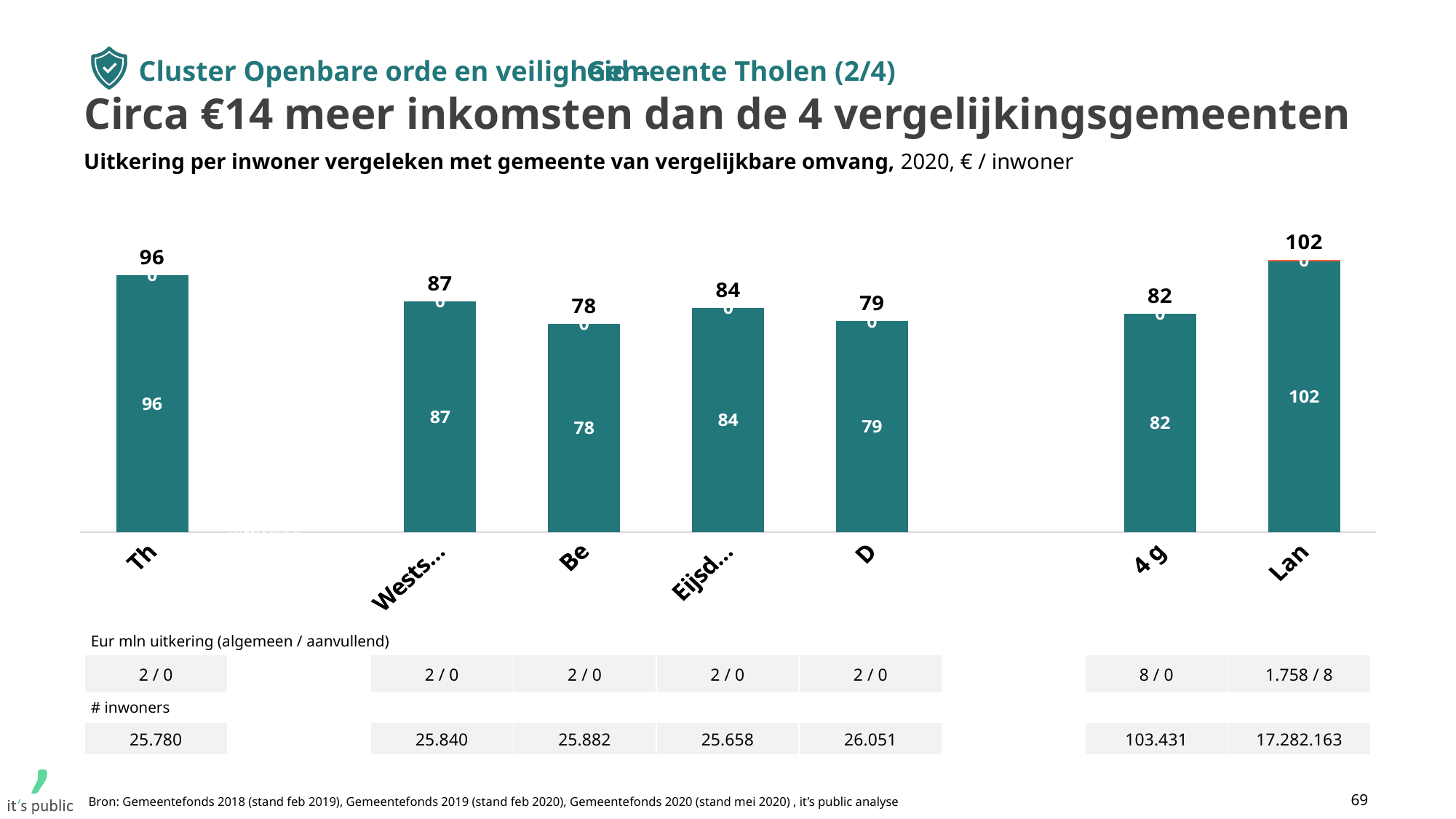
What is the unit of the values shown in the chart? € / inwoner What is the difference between the values for Th and 4 g? 14 What is the value for Be? 78 How many bars are shown in the chart? 7 What kind of chart is shown on the slide? bar chart Which is larger, the value for Wests... or the value for Eijsd...? Wests... What is the value for Th? 96 What is the value for Lan? 102 What is the value for 4 g? 82 What is the difference between the values for Lan and Th? 6 Which category has the highest value? Lan Which category has the lowest value? Be